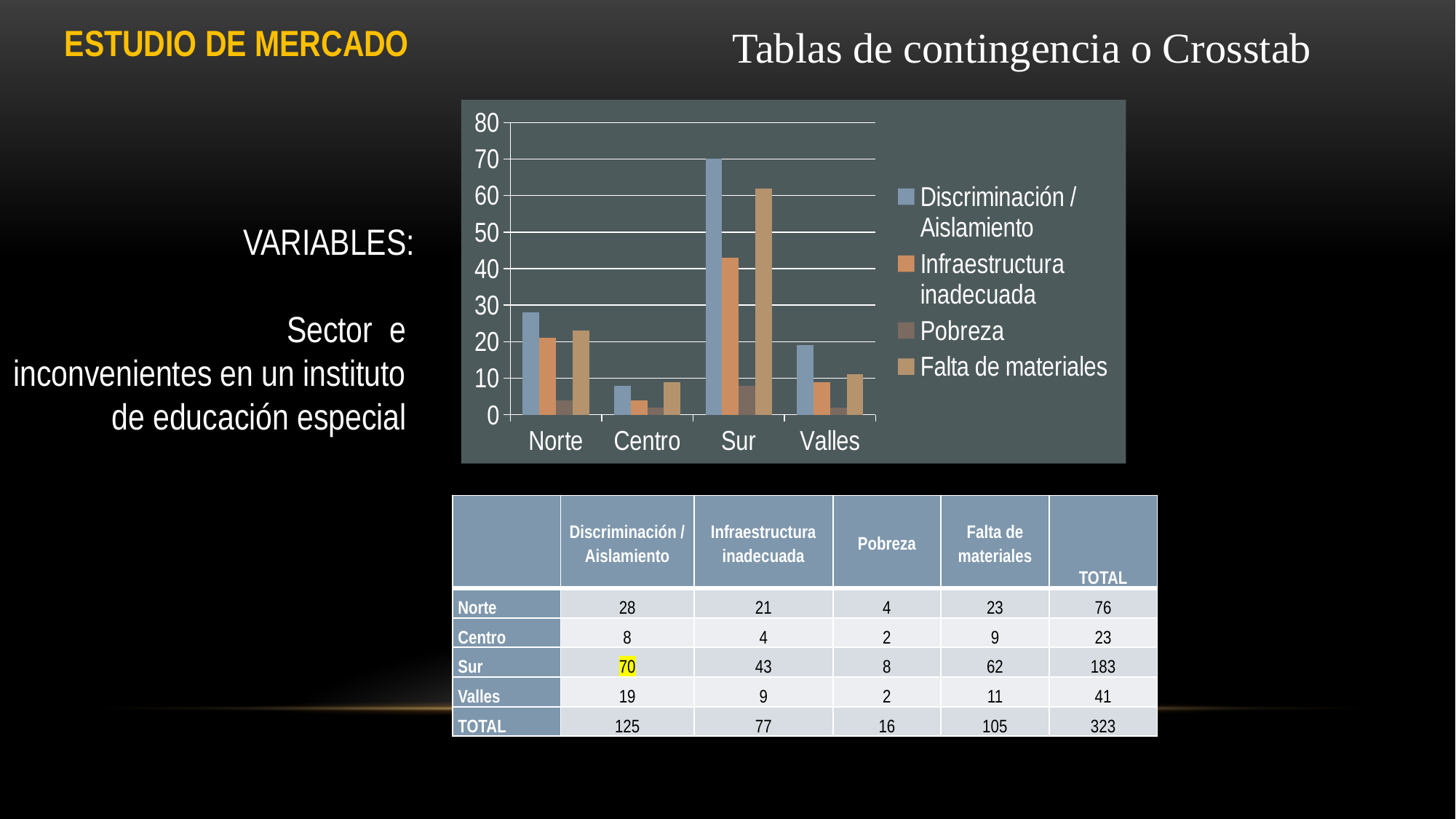
How many series does the chart legend list? 4 What is the difference between the Discriminación / Aislamiento values for Sur and Norte? 42 Which series is shown in orange in the chart? Infraestructura inadecuada Is the value for Infraestructura inadecuada in Sur greater or less than 40? greater How many sector categories are shown on the x axis of the chart? 4 Which is larger in Norte: Discriminación / Aislamiento or Falta de materiales? Discriminación / Aislamiento Which sector has the highest value for Discriminación / Aislamiento? Sur What is the value for Discriminación / Aislamiento in Sur? 70 Is the value for Discriminación / Aislamiento in Valles greater or less than 20? less What is the value for Falta de materiales in Sur? 62 What type of chart is shown on the slide? bar chart Which sector has the lowest value for Falta de materiales? Centro